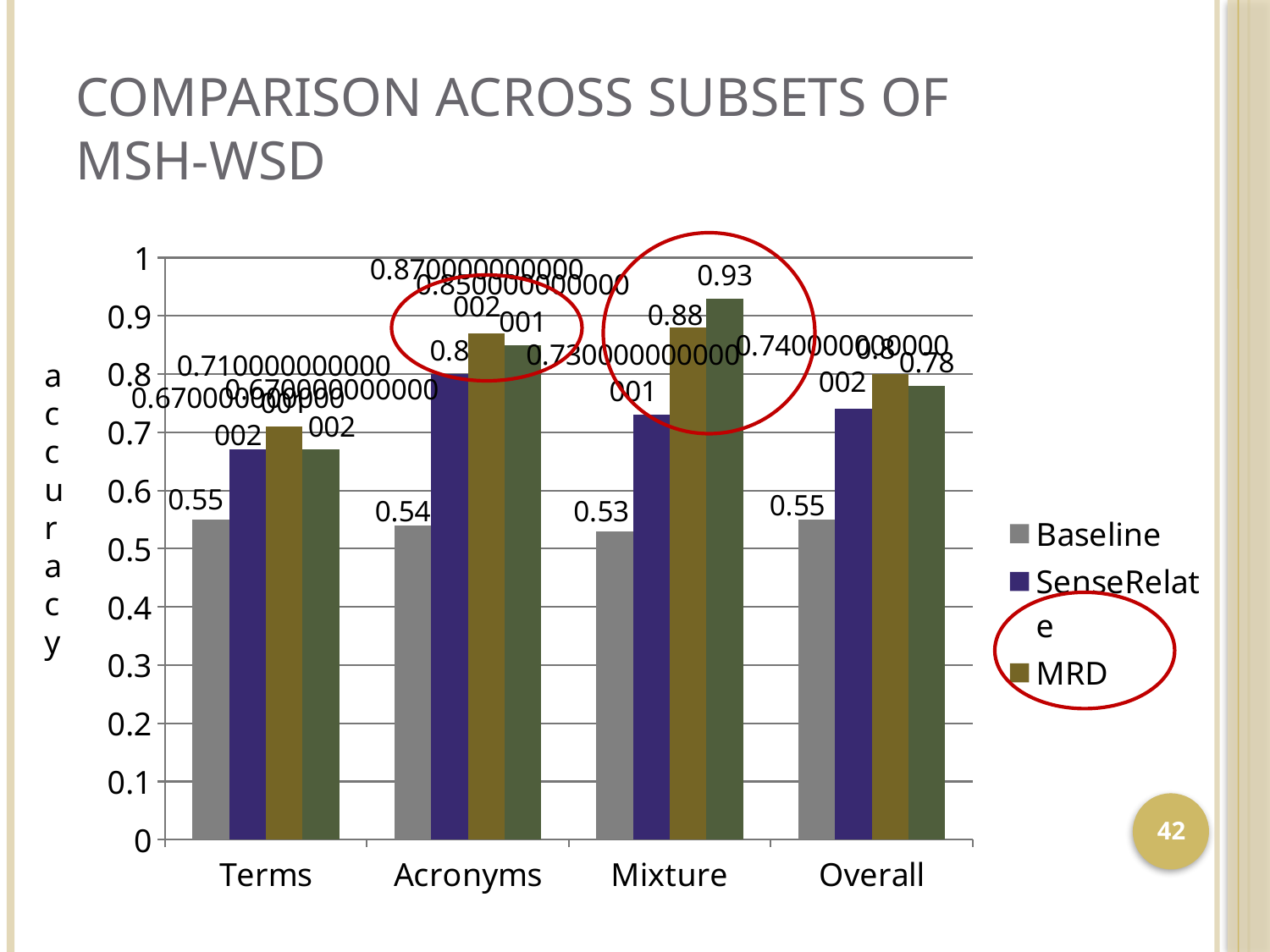
What is the Baseline accuracy for the Terms subset? 0.55 Which subset has the lowest Baseline accuracy? Mixture What is the Baseline accuracy for the Mixture subset? 0.53 What is the difference between the Baseline accuracy for Terms and the Baseline accuracy for Mixture? 0.02 What kind of chart is shown on the slide? bar chart Is the SenseRelate accuracy for the Terms subset greater or less than 0.6? greater What is the MRD accuracy for the Mixture subset? 0.88 Which legend entry is circled in red? MRD How many subsets (categories) are shown on the x axis? 4 What is the SenseRelate accuracy for the Acronyms subset? 0.8 For the Mixture subset, which is larger: the MRD accuracy or the Baseline accuracy? MRD What is the label on the y axis? accuracy